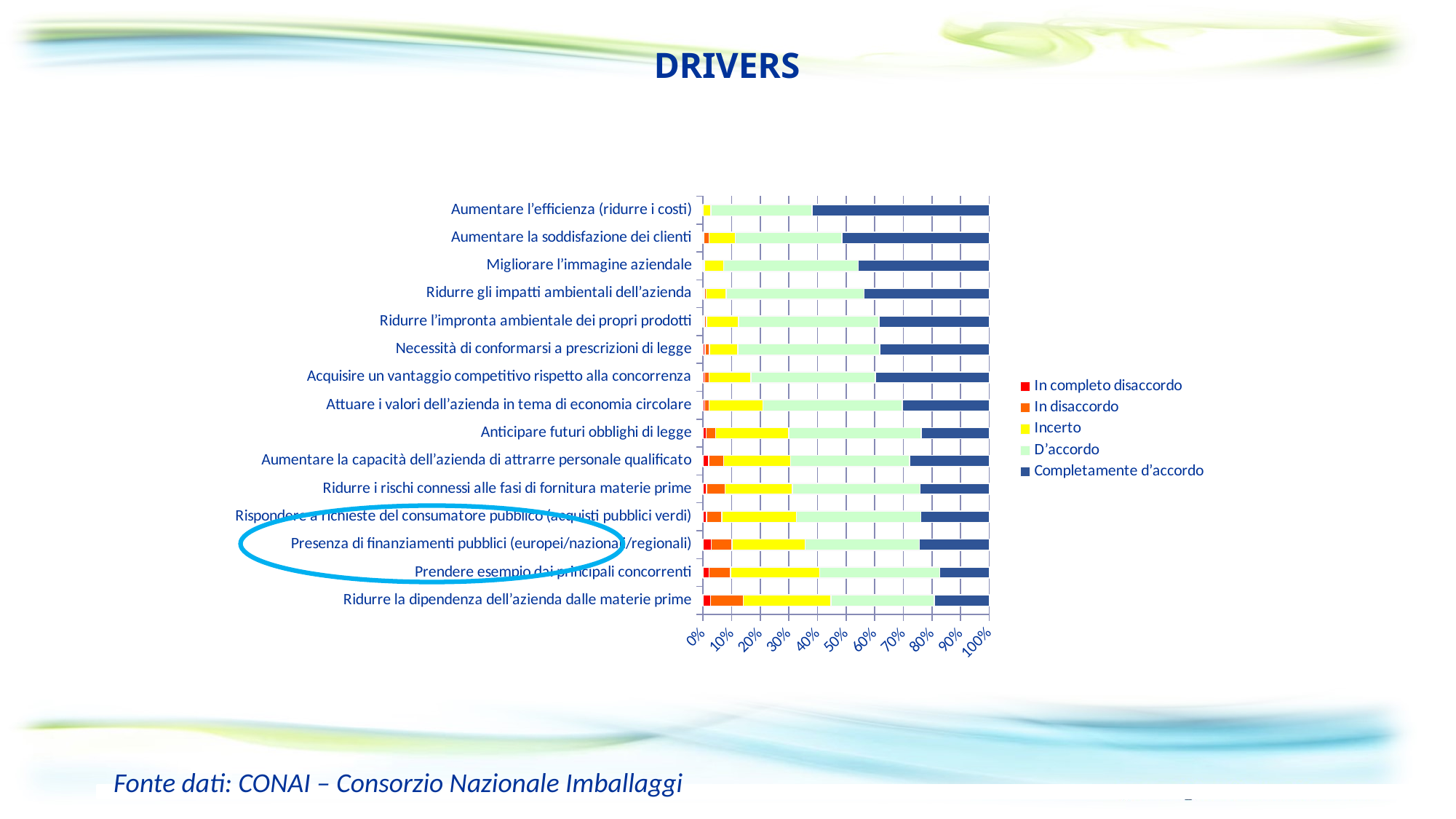
What kind of chart is shown on the slide? Stacked bar chart What is the title of the slide containing the chart? DRIVERS Is the 'Completamente d'accordo' share for 'Ridurre la dipendenza dell'azienda dalle materie prime' greater or less than 30%? less Which has the larger 'Incerto' share: 'Attuare i valori dell'azienda in tema di economia circolare' or 'Migliorare l'immagine aziendale'? Attuare i valori dell'azienda in tema di economia circolare Is the 'Incerto' share for 'Aumentare l'efficienza (ridurre i costi)' greater or less than 10%? less Is the 'Completamente d'accordo' share for 'Aumentare l'efficienza (ridurre i costi)' greater or less than 50%? greater How many categories (drivers) are plotted on the chart? 15 Which has the larger 'Completamente d'accordo' share: 'Aumentare l'efficienza (ridurre i costi)' or 'Prendere esempio dai principali concorrenti'? Aumentare l'efficienza (ridurre i costi) How many series does the chart legend list? 5 Which category label on the chart is circled? Presenza di finanziamenti pubblici (europei/nazionali/regionali) Which category has the largest 'Completamente d'accordo' share? Aumentare l'efficienza (ridurre i costi) Which category has the largest 'In disaccordo' share? Ridurre la dipendenza dell'azienda dalle materie prime